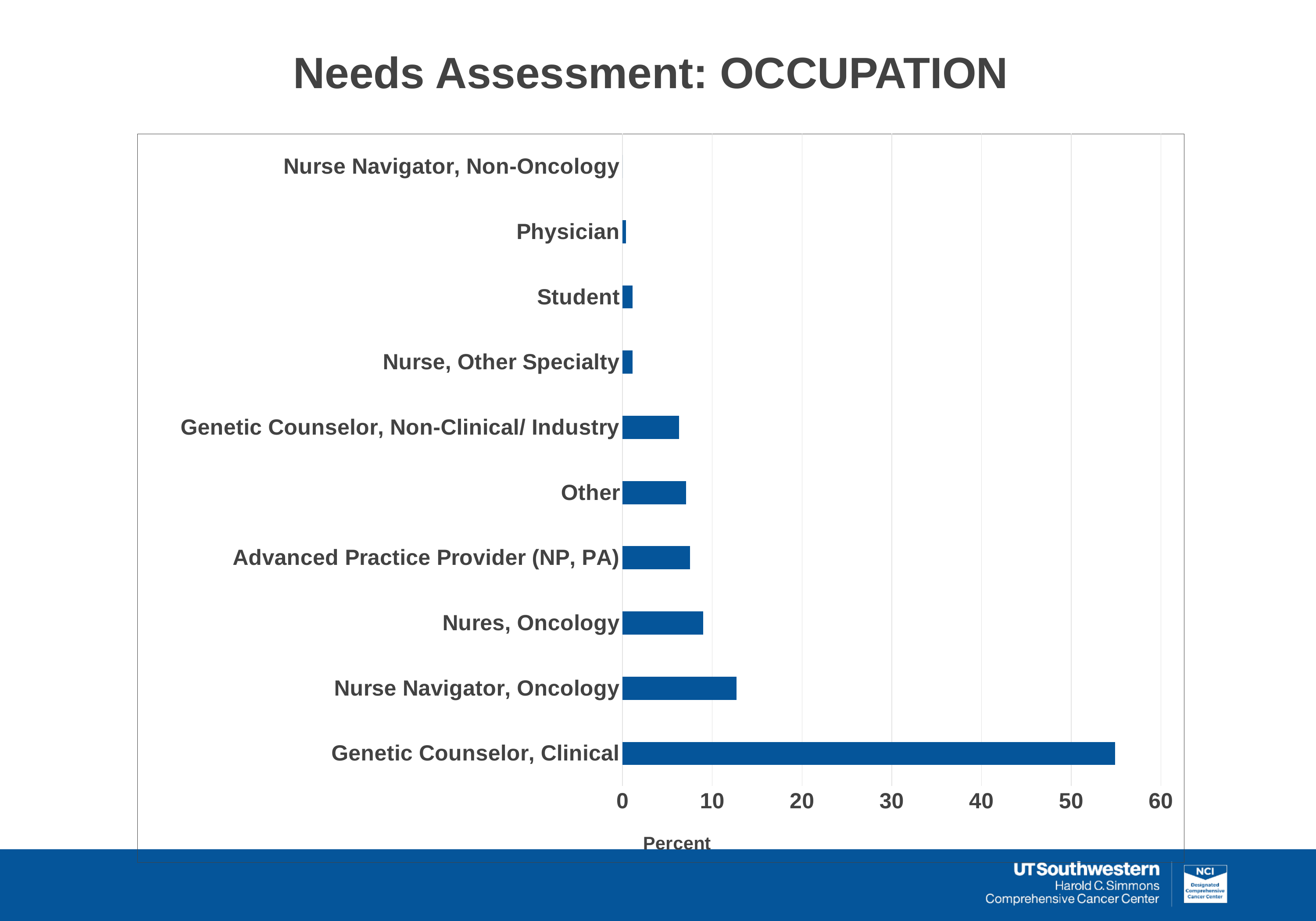
How many occupation categories are plotted in the chart? 10 What is the title of the slide containing the chart? Needs Assessment: OCCUPATION What is the label on the horizontal axis of the chart? Percent Is the value for Nures, Oncology greater or less than 10? less Is the value for Genetic Counselor, Non-Clinical/ Industry greater or less than 10? less Is the value for Genetic Counselor, Clinical greater or less than 50? greater Which occupation has the lowest percentage in the chart? Nurse Navigator, Non-Oncology Which occupation has the highest percentage in the chart? Genetic Counselor, Clinical What kind of chart is shown on the slide? Bar chart Which is larger, the value for Genetic Counselor, Clinical or the value for Nurse Navigator, Oncology? Genetic Counselor, Clinical Which is larger, the value for Nures, Oncology or the value for Other? Nures, Oncology